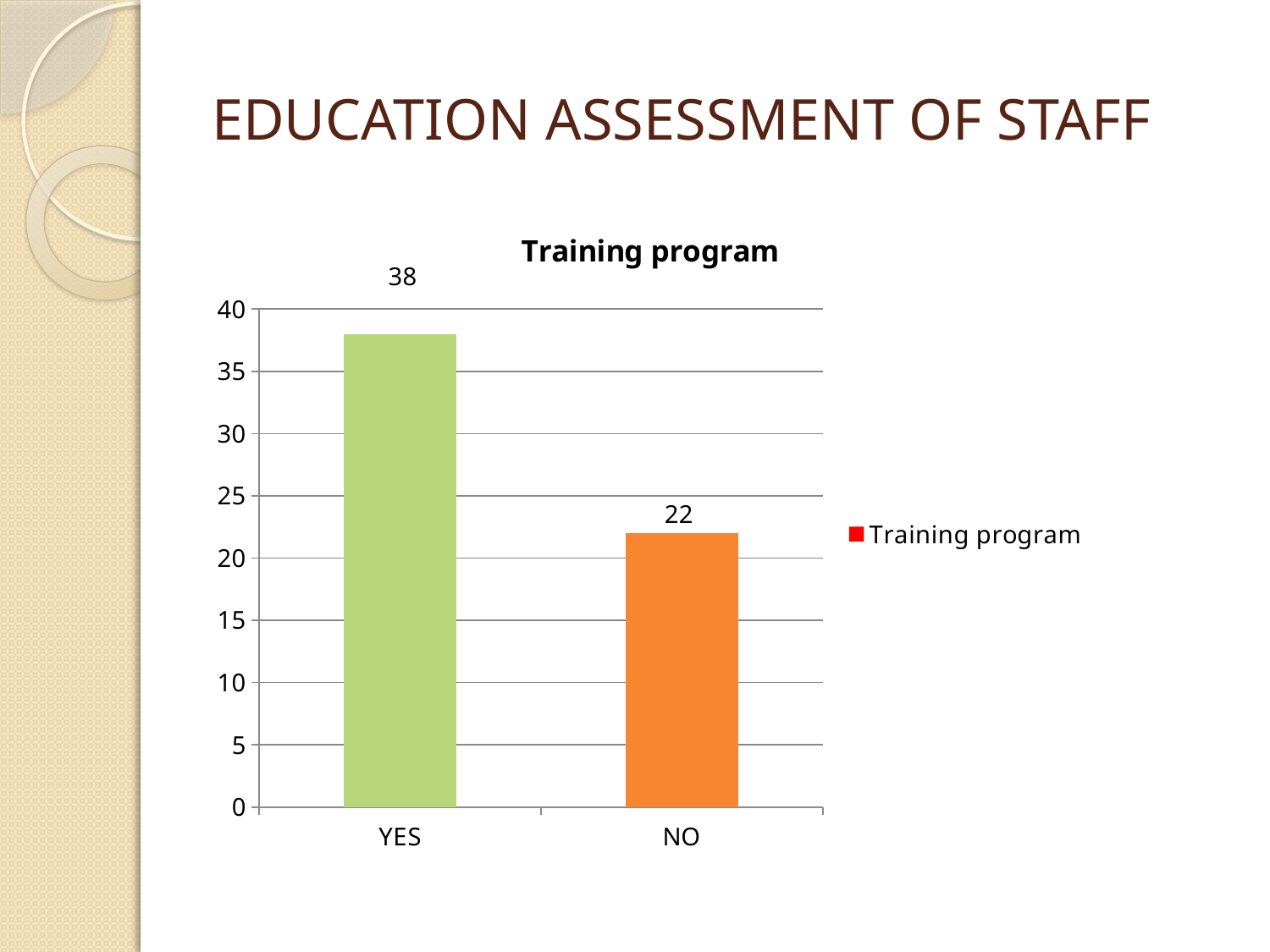
How many series does the legend list? 1 What is the difference between the YES and NO values in the Training program chart? 16 How many categories are shown in the Training program chart? 2 Is the value for NO greater or less than 25? less What is the value for YES in the Training program chart? 38 Which is larger in the Training program chart, YES or NO? YES What is the value for NO in the Training program chart? 22 What is the title of the chart? Training program Is the value for YES greater or less than 35? greater Which category has the highest value in the Training program chart? YES What kind of chart is shown on the slide? Bar chart Which category has the lowest value in the Training program chart? NO